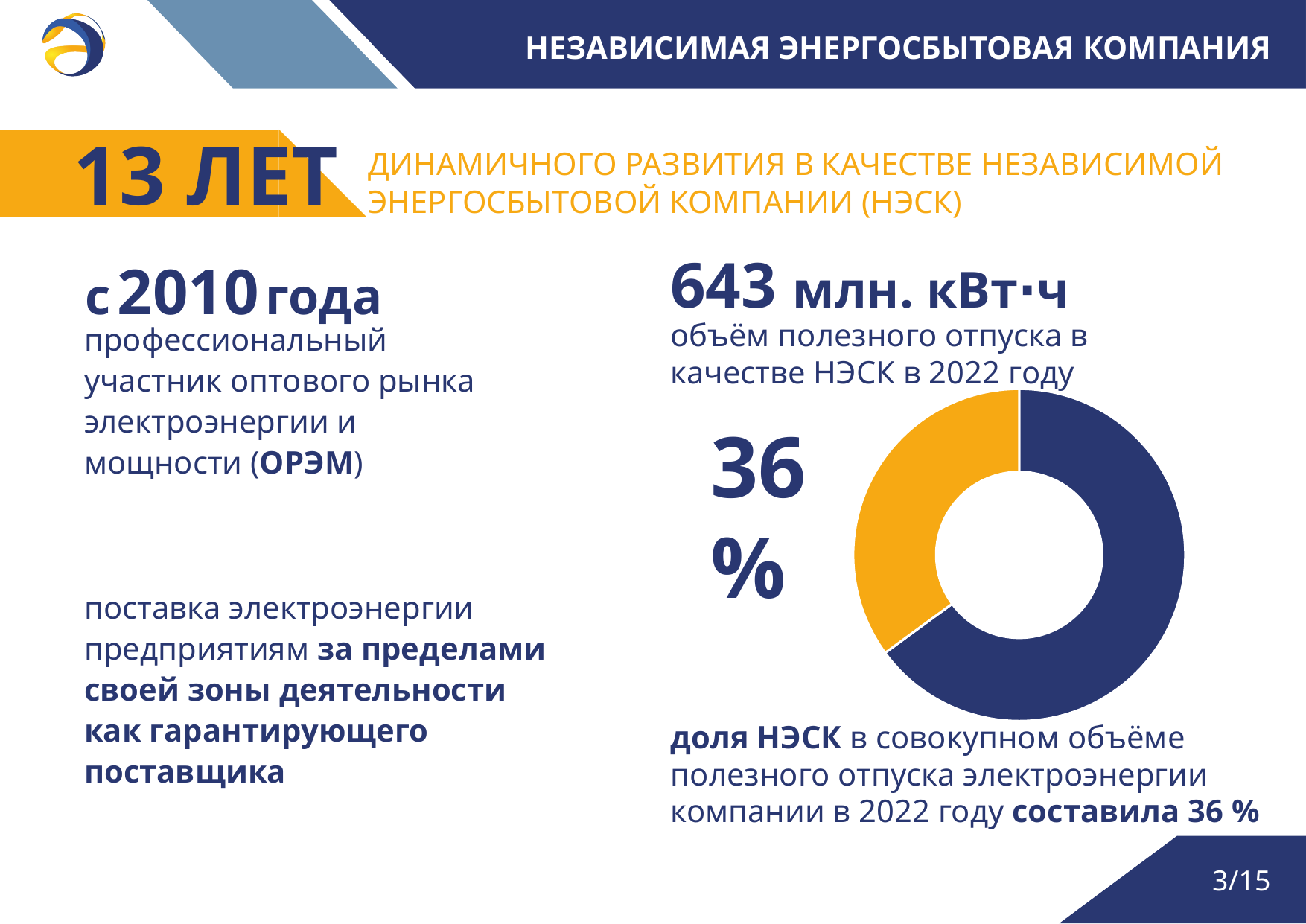
Which slice of the donut chart is the largest? dark blue Is the share of the dark blue slice greater or less than 50%? greater What share of the donut chart does the orange slice represent? 36 % Which slice of the donut chart is the smallest? orange (36 %) What was the share of НЭСК in the company's total useful electricity output in 2022, according to the chart? 36 % How many slices does the donut chart have? 2 Which slice of the donut chart is larger, the orange one or the dark blue one? dark blue Is the share of the orange slice greater or less than 50%? less Does the donut chart have a legend? No What colour is the slice labelled 36 %? orange What kind of chart is shown on the slide? pie chart (donut)